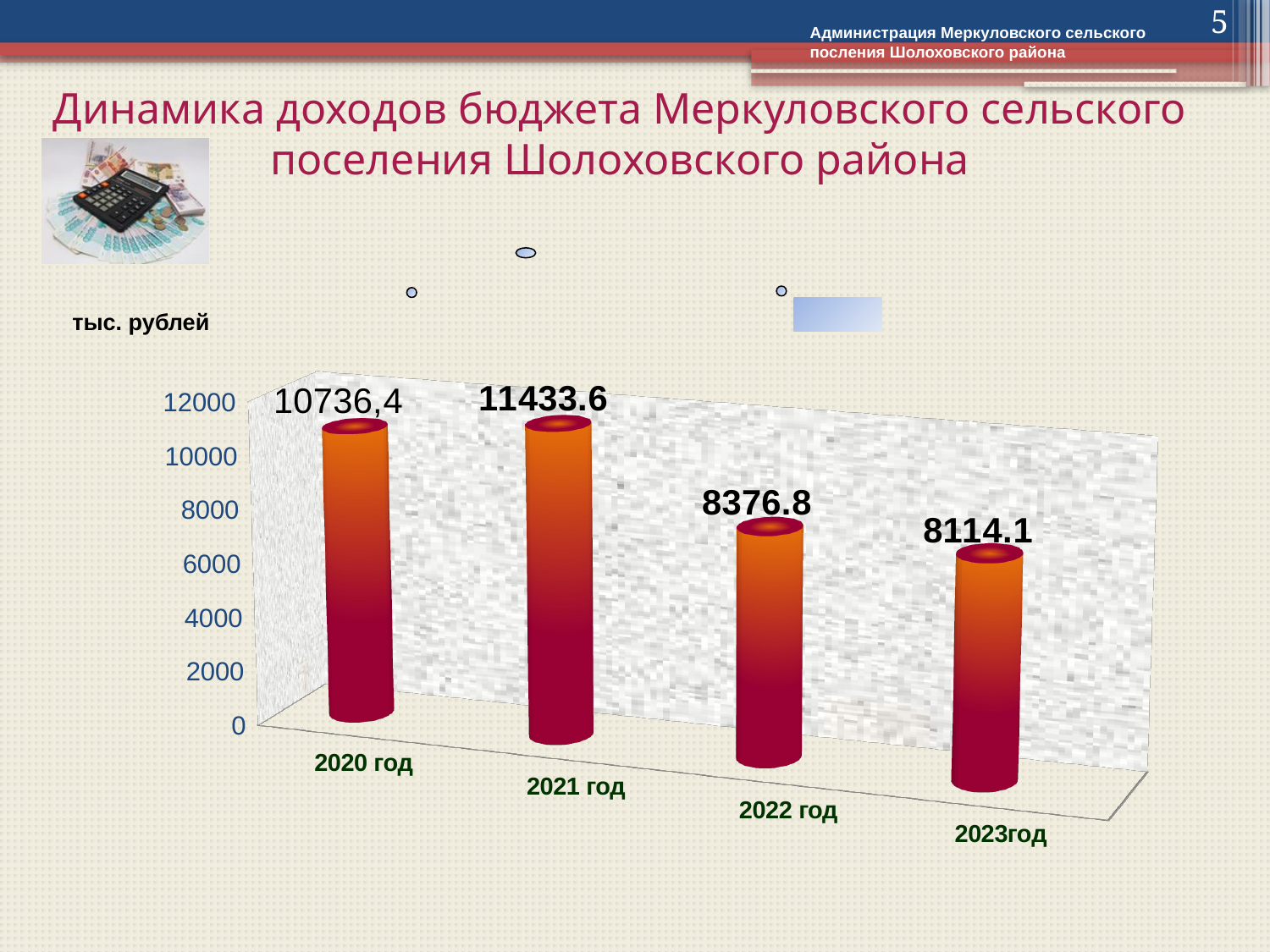
What is the difference between the values for 2021 год and 2023год? 3319.5 What is the difference between the values for 2022 год and 2023год? 262.7 Which year has the lowest budget income on the chart? 2023год Do the values rise or fall from 2021 год to 2023год? Fall What is the budget income value shown for 2020 год? 10736,4 What is the budget income value shown for 2023год? 8114.1 What is the budget income value shown for 2021 год? 11433.6 What is the budget income value shown for 2022 год? 8376.8 How many years (categories) are shown on the chart? 4 Which year has the highest budget income on the chart? 2021 год Which is larger, the value for 2020 год or the value for 2022 год? 2020 год What kind of chart is shown on the slide? Bar chart